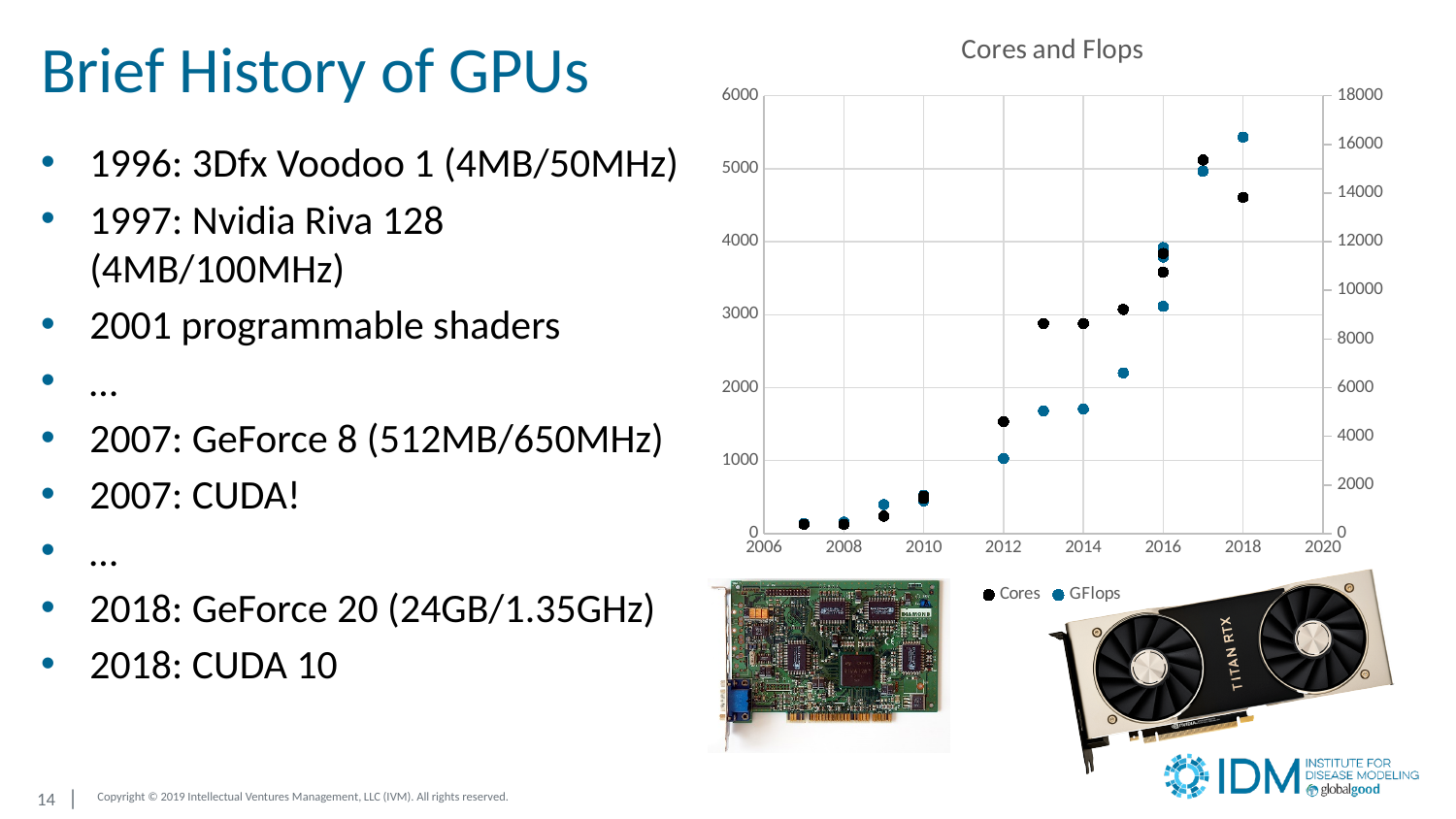
Is the Cores value for 2008 greater or less than 1000? less Is the Cores value for 2013 greater or less than 2000? greater How many series does the chart's legend list? 2 Is the Cores value for 2018 greater or less than 4000? greater What are the two series named in the chart's legend? Cores and GFlops Which is larger, the Cores value for 2018 or the Cores value for 2012? 2018 Do the Cores values generally rise or fall from 2006 to 2020? rise Which year has the highest Cores value? 2017 What kind of chart is shown on the slide? scatter chart What is the title of the chart? Cores and Flops